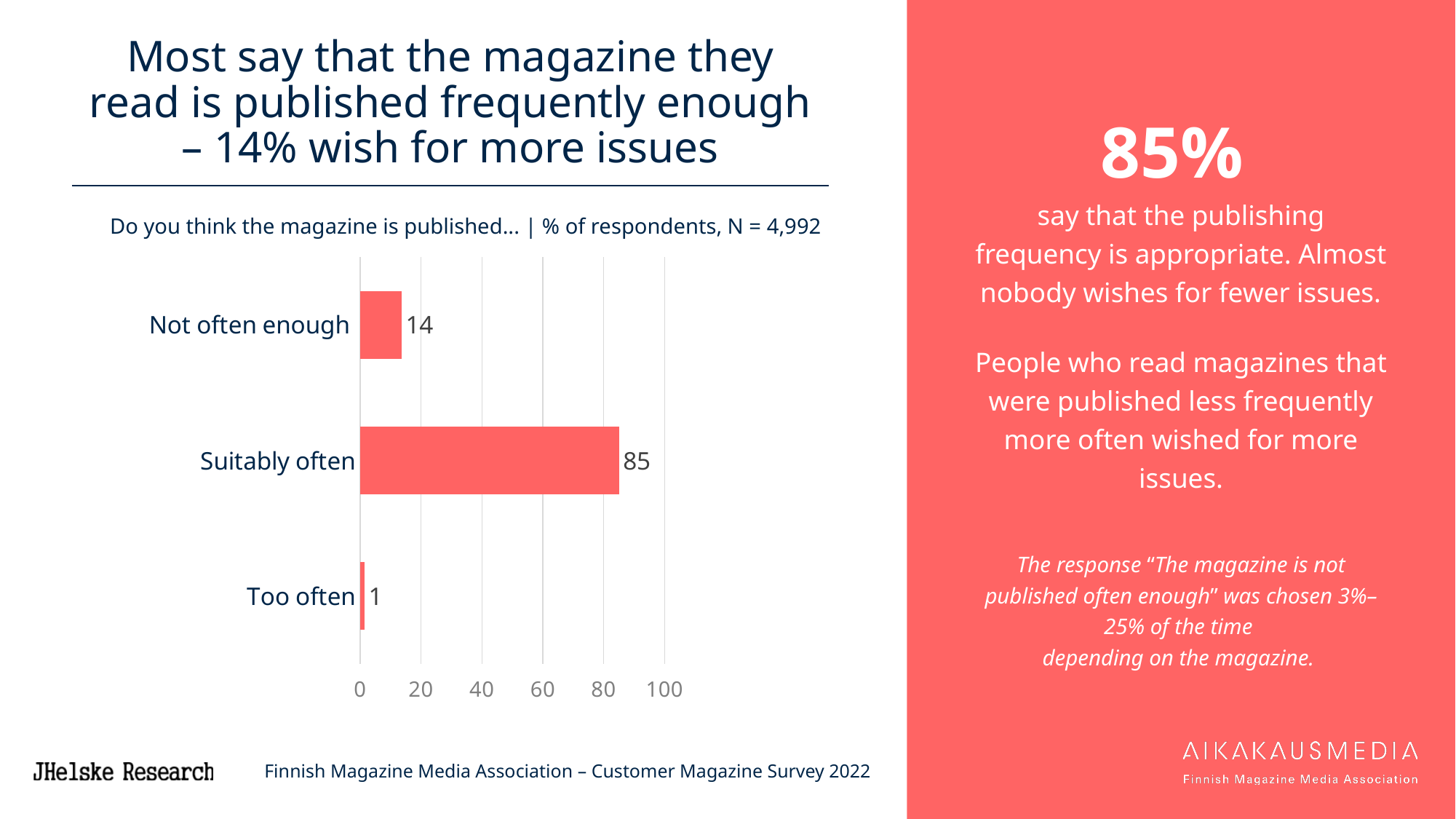
Is the value for "Not often enough" greater or less than 20? less Which response category has the lowest value? Too often What percentage of respondents said the magazine is published "Not often enough"? 14 Is the value for "Suitably often" greater or less than 80? greater What is the sample size (N) stated in the chart subtitle? 4,992 Which response category has the highest value? Suitably often What percentage of respondents said the magazine is published "Too often"? 1 What type of chart is shown on the slide? Bar chart What is the difference between the values for "Suitably often" and "Not often enough"? 71 How many response categories are shown in the chart? 3 Which is larger, the value for "Not often enough" or the value for "Too often"? Not often enough What percentage of respondents said the magazine is published "Suitably often"? 85